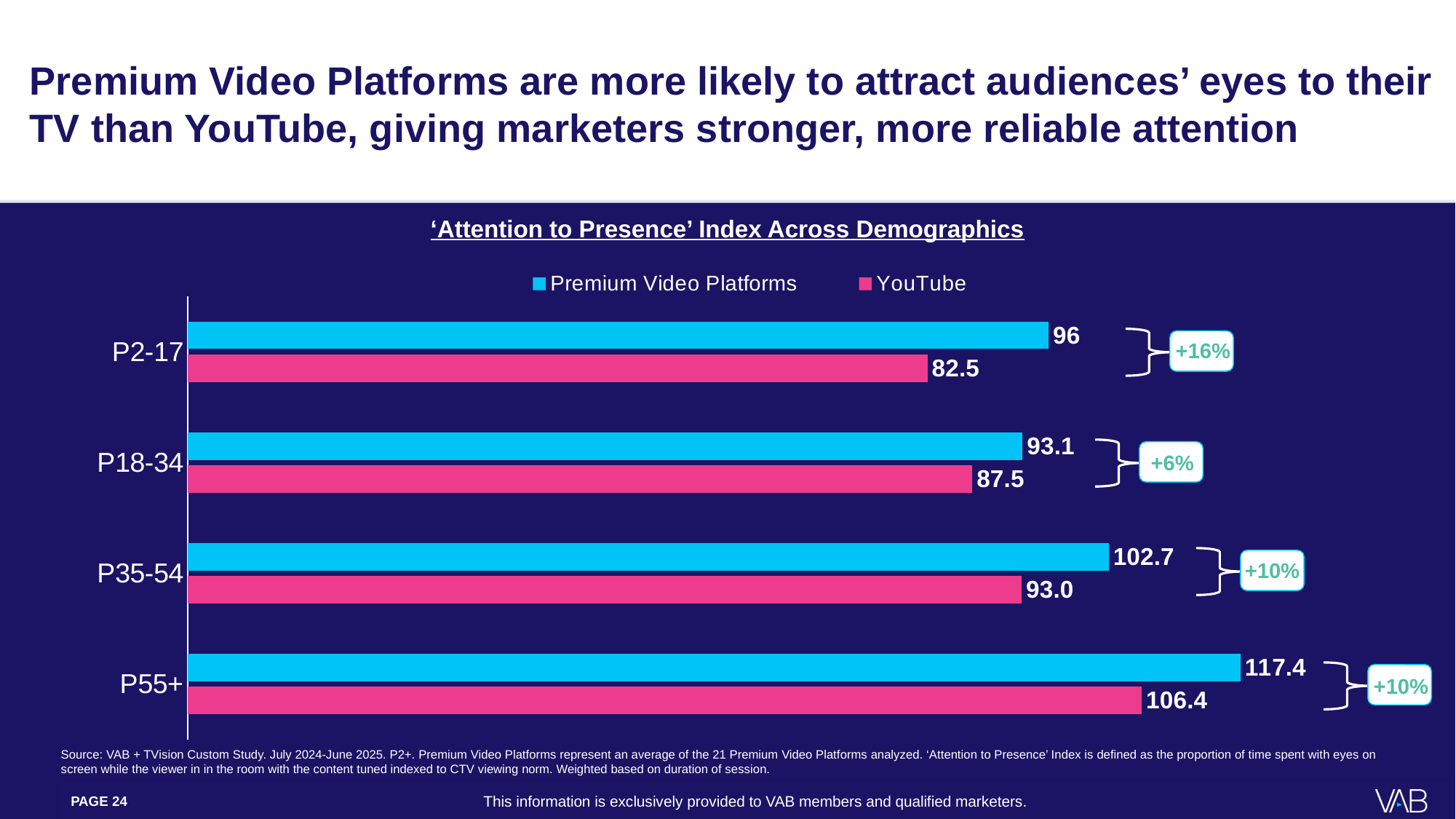
What percentage lift is annotated for the P18-34 demographic? +6% What is the 'Attention to Presence' Index value for Premium Video Platforms among P2-17? 96 What is the Premium Video Platforms value for P55+? 117.4 What type of chart is shown on the slide? Bar chart What is the title of the chart? 'Attention to Presence' Index Across Demographics How many demographic groups are shown on the chart? 4 How many series does the legend list? 2 For P2-17, which is larger: the Premium Video Platforms value or the YouTube value? Premium Video Platforms What is the YouTube value for the P18-34 demographic? 87.5 What is the difference between the Premium Video Platforms and YouTube values for P35-54? 9.7 Which demographic has the highest YouTube value? P55+ Which demographic has the lowest Premium Video Platforms value? P2-17